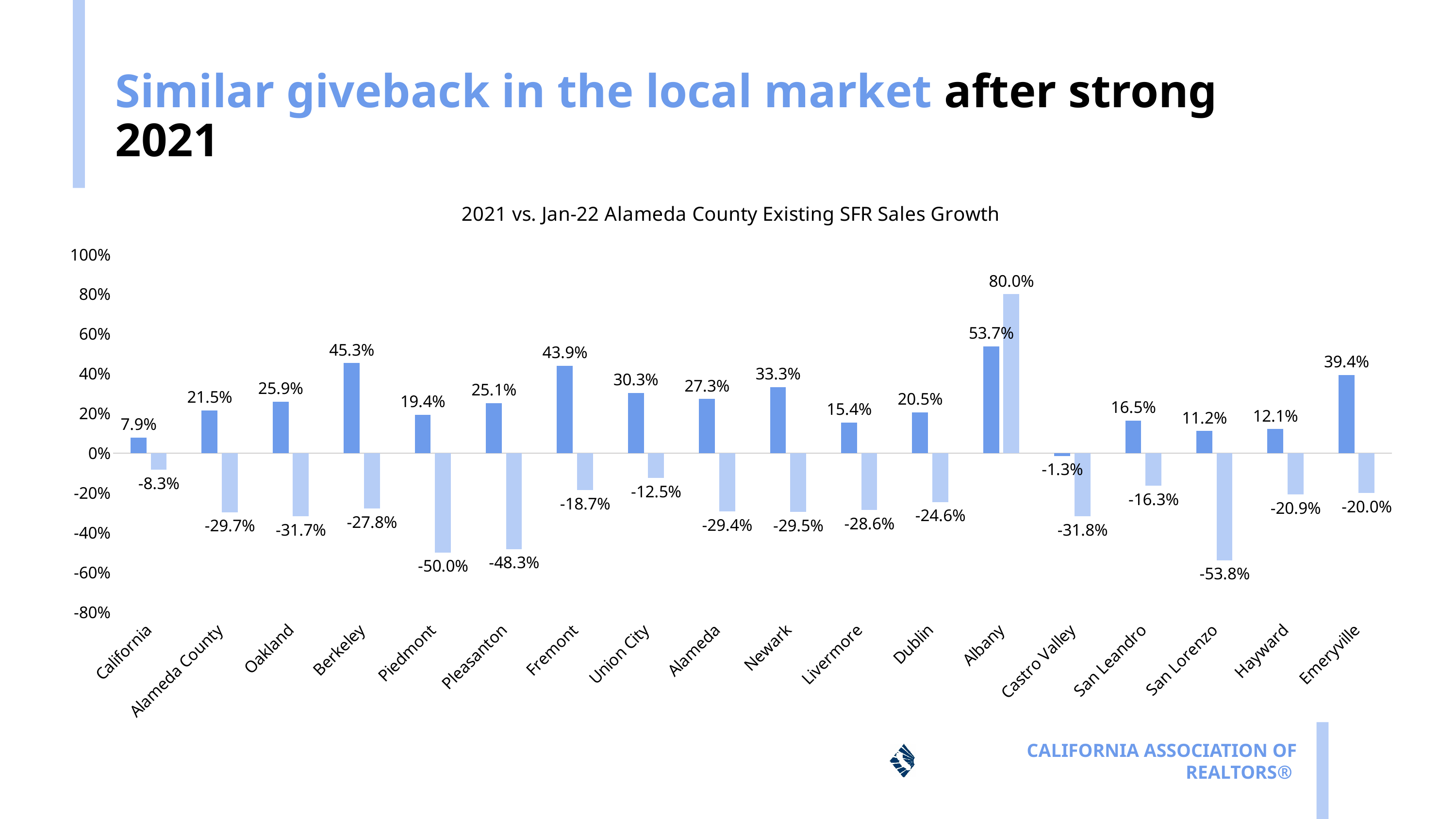
What is the difference between the darker blue (2021) value for Fremont and for Oakland? 18.0 percentage points Which city has the lowest lighter blue (Jan-22) value? San Lorenzo What is the title of the chart? 2021 vs. Jan-22 Alameda County Existing SFR Sales Growth What is the darker blue (2021) value for Berkeley? 45.3% What is the lighter blue (Jan-22) value for Albany? 80.0% Which city has the highest darker blue (2021) value? Albany What is the lighter blue (Jan-22) value for San Lorenzo? -53.8% What kind of chart is shown on the slide? bar chart Which is larger, the darker blue (2021) value for Fremont or for Oakland? Fremont What is the darker blue (2021) value for California? 7.9% Which city has the lowest darker blue (2021) value? Castro Valley How many cities or regions are shown along the x axis of the chart? 18